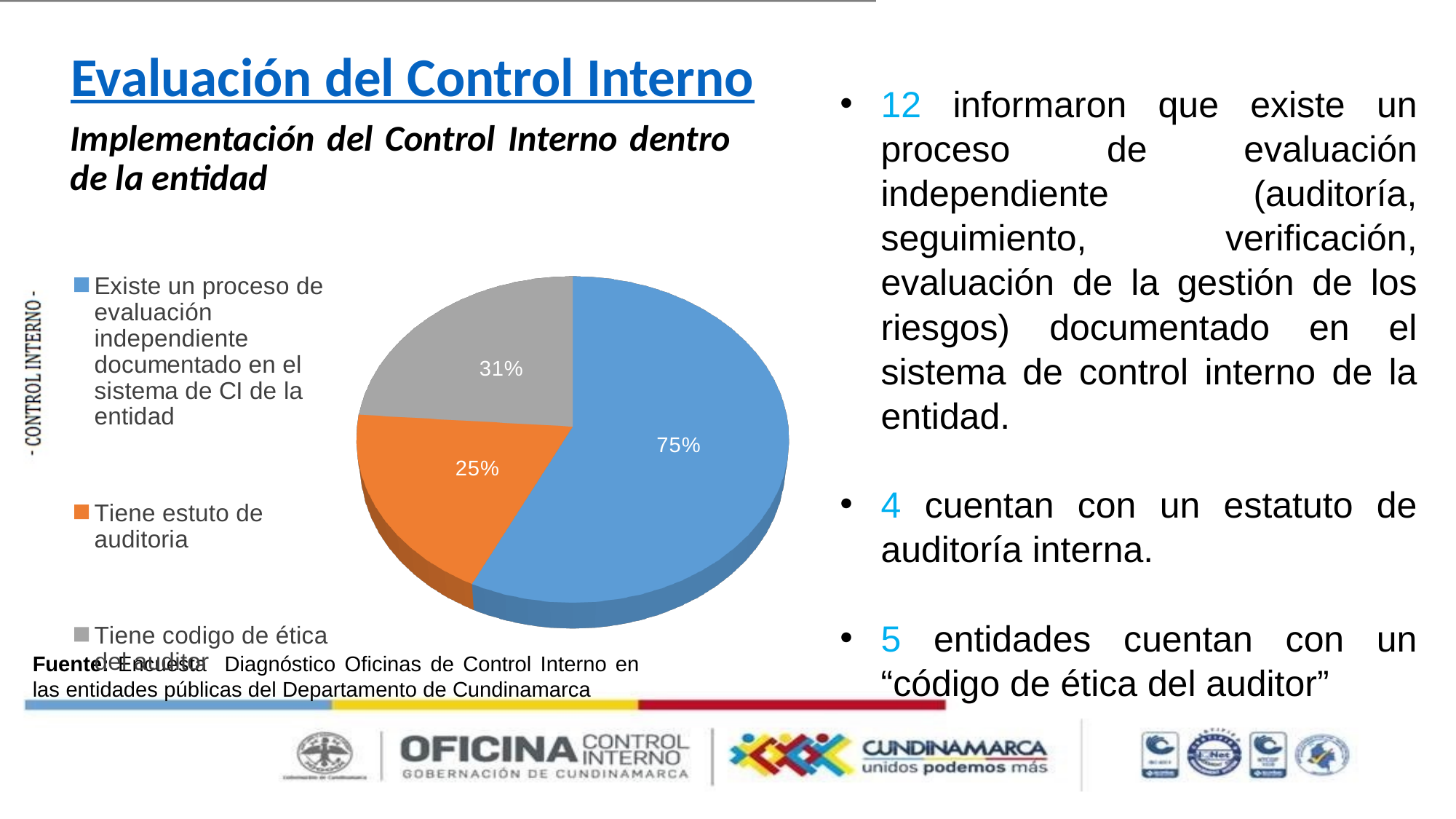
What is the difference between the 'Tiene codigo de ética del auditor' slice and the 'Tiene estuto de auditoria' slice? 6% What percentage is shown for the slice 'Tiene codigo de ética del auditor'? 31% What is the difference between the 75% slice and the 25% slice? 50% Which is larger: the 'Tiene codigo de ética del auditor' slice or the 'Tiene estuto de auditoria' slice? Tiene codigo de ética del auditor What type of chart is shown on the slide? Pie chart What colour is the slice labelled 75%? Blue Which slice of the pie chart has the smallest value? Tiene estuto de auditoria How many entries does the legend list? 3 What percentage is shown for the slice 'Existe un proceso de evaluación independiente documentado en el sistema de CI de la entidad'? 75% What percentage is shown for the slice 'Tiene estuto de auditoria'? 25% How many slices does the pie chart have? 3 Which slice of the pie chart has the largest value? Existe un proceso de evaluación independiente documentado en el sistema de CI de la entidad